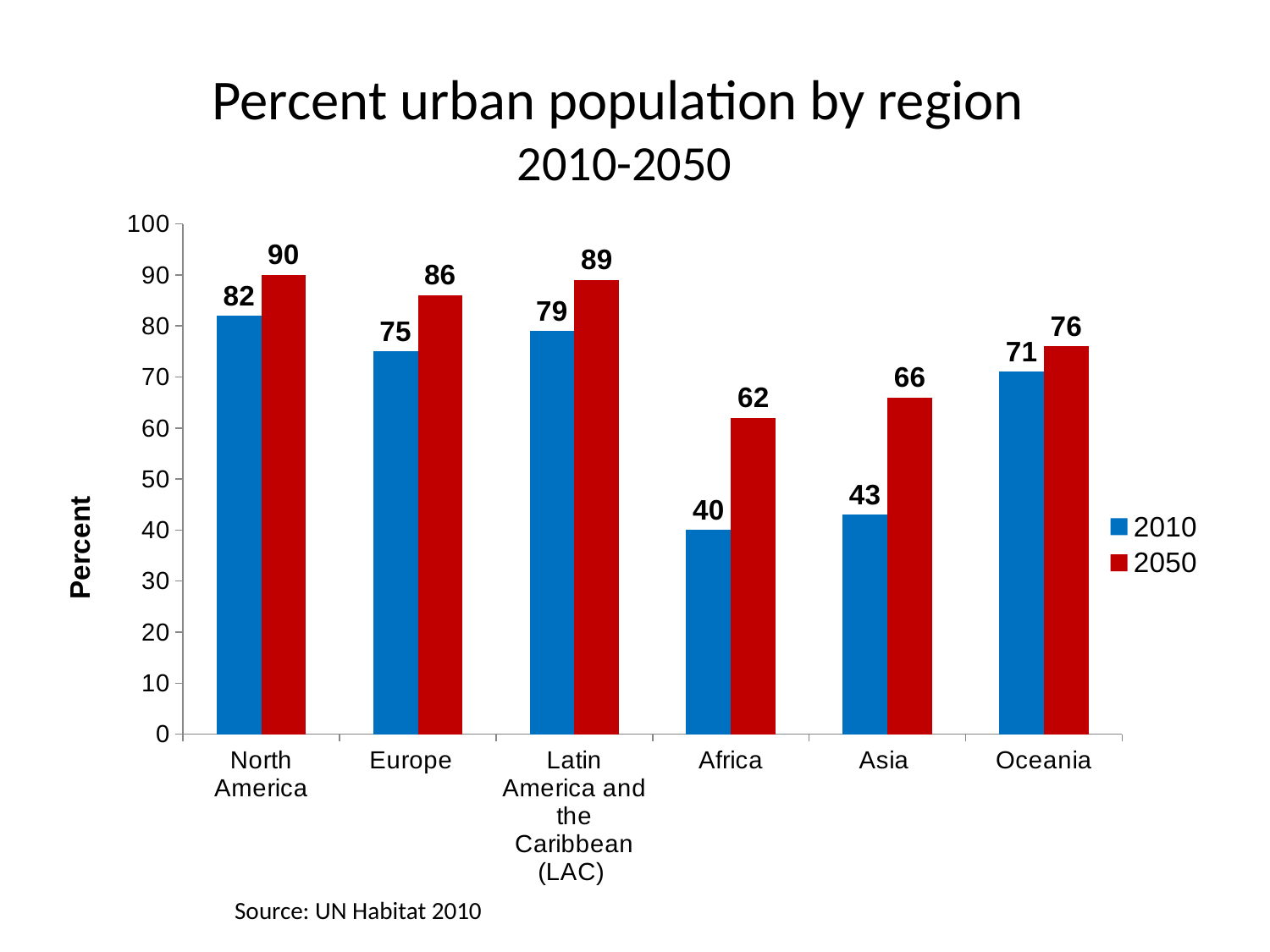
What is the difference between the 2050 and 2010 values for Asia? 23 How many series does the legend list? 2 What is the 2050 value for Latin America and the Caribbean (LAC)? 89 Which region has the highest 2050 percent urban population? North America What is the source cited below the chart? UN Habitat 2010 Which region has the lowest 2010 percent urban population? Africa What is the 2050 percent urban population for Africa? 62 Is the 2010 value for Africa greater or less than 50? less What is the 2010 percent urban population for North America? 82 What kind of chart is shown on the slide? bar chart Which is larger: the 2010 value for Europe or the 2010 value for Oceania? Europe How many regions are shown on the x axis? 6